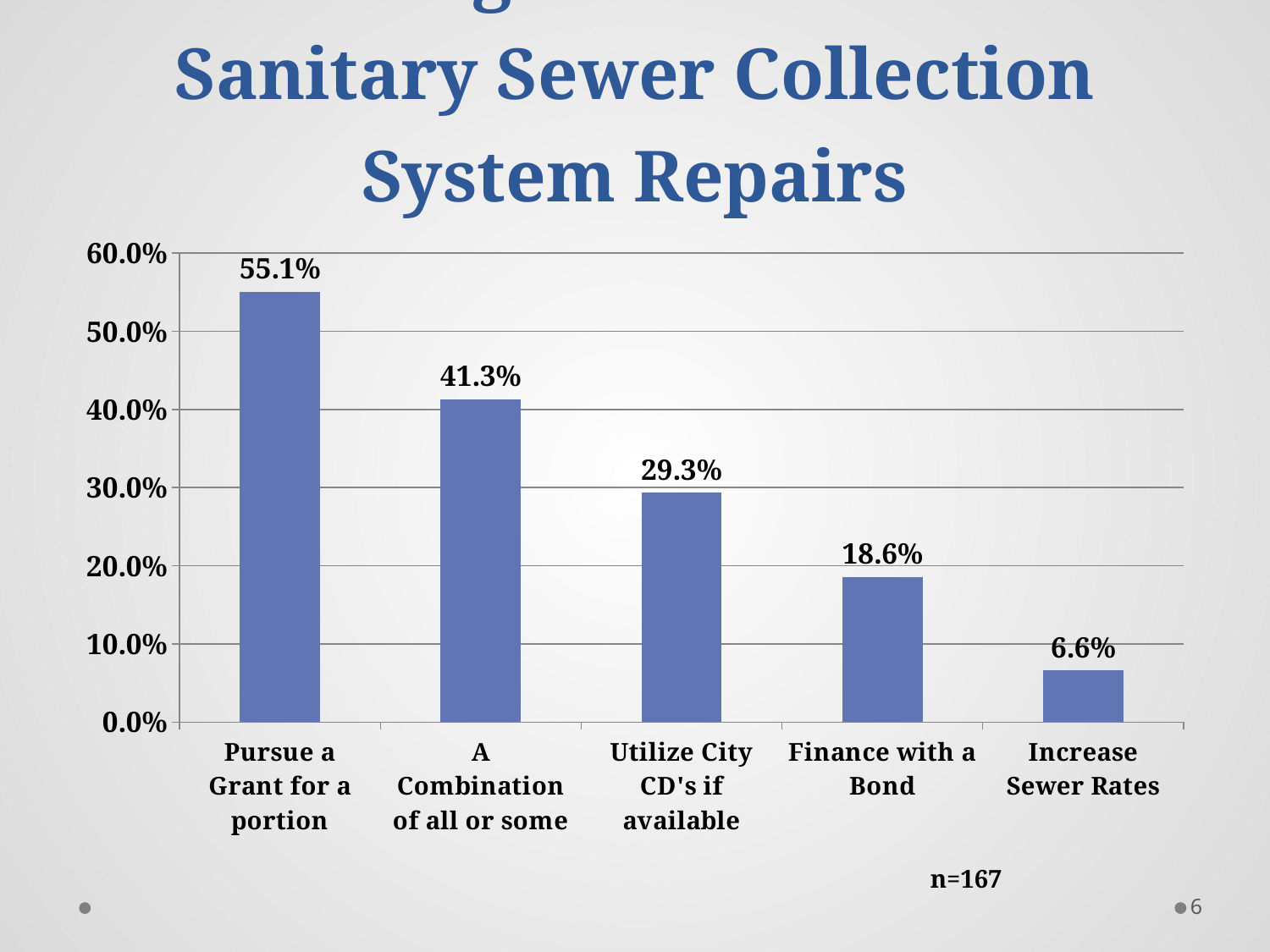
What kind of chart is shown on the slide? bar chart Is the value for "Utilize City CD's if available" greater or less than 30.0%? less Which category has the highest value? Pursue a Grant for a portion Which is larger, "A Combination of all or some" or "Utilize City CD's if available"? A Combination of all or some What is the value for "Increase Sewer Rates"? 6.6% What is the difference between "Utilize City CD's if available" and "Finance with a Bond"? 10.7% What sample size is noted below the chart? n=167 What is the difference between "Pursue a Grant for a portion" and "A Combination of all or some"? 13.8% What is the value for "Finance with a Bond"? 18.6% Which category has the lowest value? Increase Sewer Rates How many categories are shown in the chart? 5 What is the value for "Pursue a Grant for a portion"? 55.1%